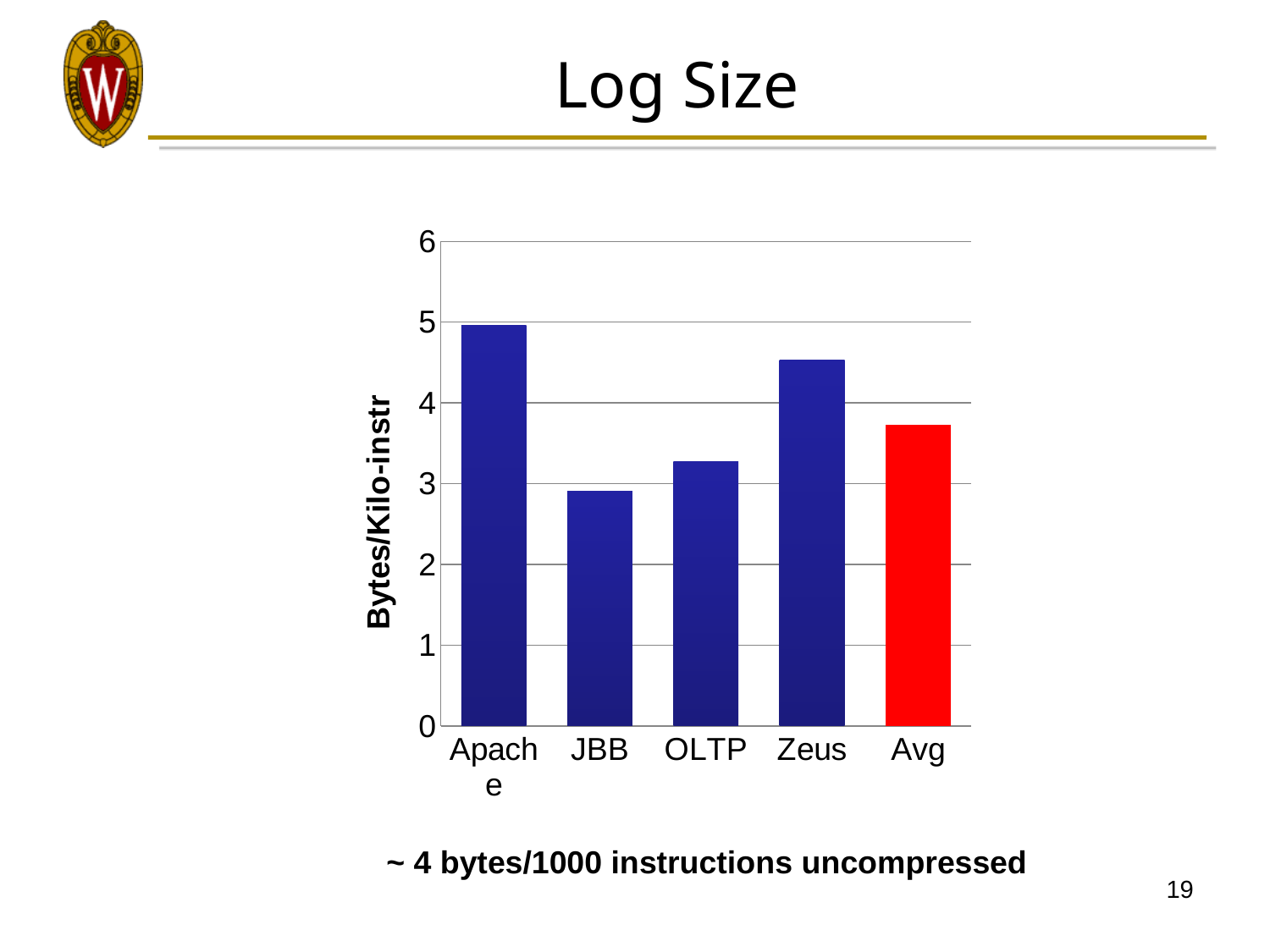
Which has a larger value, Apache or Zeus? Apache Is the value for Avg greater or less than 4? less Which category has the highest value in the chart? Apache How many categories are shown on the x axis of the chart? 5 Is the value for Apache greater or less than 4? greater What is the label on the y axis of the chart? Bytes/Kilo-instr Which category has the lowest value in the chart? JBB What kind of chart is shown on the slide? bar chart Is the value for JBB greater or less than 3? less Which has a larger value, OLTP or JBB? OLTP Which bar in the chart is coloured red? Avg